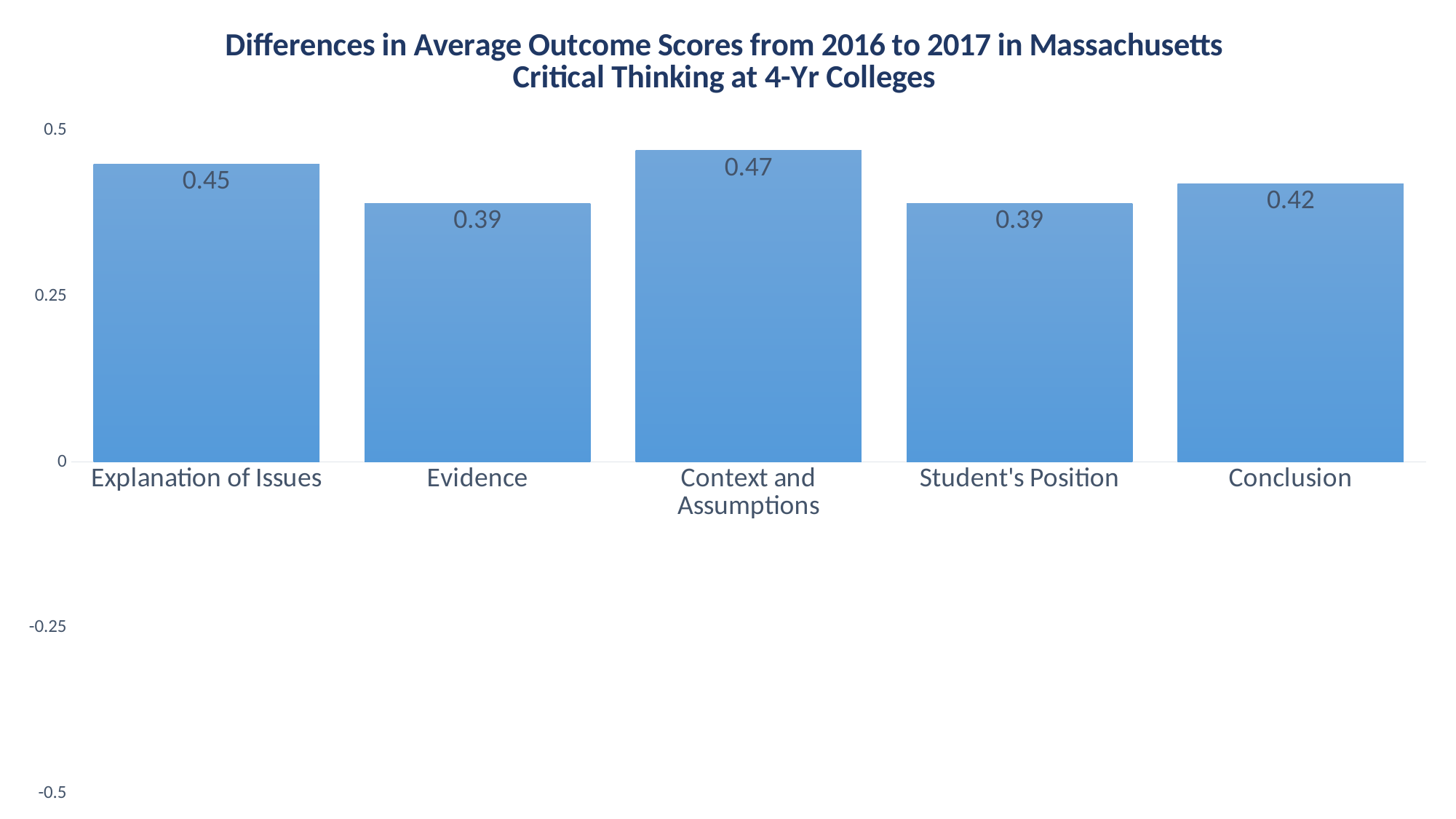
What kind of chart is shown on the slide? Bar chart What is the difference between the values for Context and Assumptions and Evidence? 0.08 What is the value for Evidence? 0.39 What is the difference between the values for Explanation of Issues and Conclusion? 0.03 What is the value for Explanation of Issues? 0.45 How many categories are shown on the x axis? 5 Which is larger, the value for Explanation of Issues or the value for Conclusion? Explanation of Issues Is the value for Student's Position greater or less than 0.25? greater What is the title of the chart? Differences in Average Outcome Scores from 2016 to 2017 in Massachusetts Critical Thinking at 4-Yr Colleges Which category has the highest value? Context and Assumptions What is the value for Context and Assumptions? 0.47 What is the value for Conclusion? 0.42